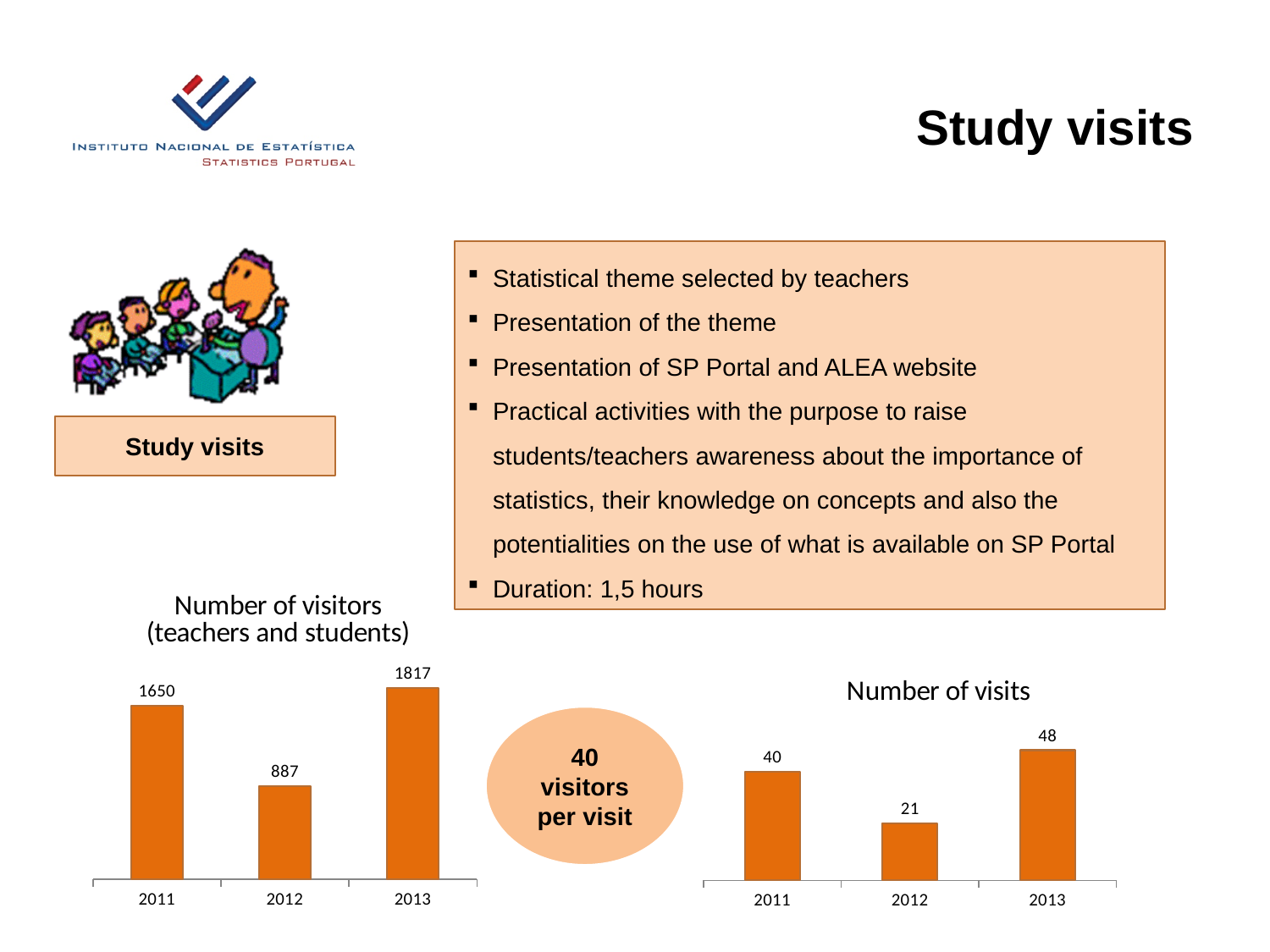
In the 'Number of visits' chart, is the value for 2011 larger or smaller than the value for 2013? smaller In the 'Number of visits' chart, which year has the lowest value? 2012 In the 'Number of visits' chart, what is the value for 2013? 48 In the 'Number of visits' chart, what is the value for 2012? 21 What kind of chart is the 'Number of visitors (teachers and students)' chart? bar chart In the 'Number of visits' chart, what is the difference between the values for 2013 and 2011? 8 How many years are shown on the x axis of the 'Number of visits' chart? 3 In the 'Number of visitors (teachers and students)' chart, which year has the highest value? 2013 In the 'Number of visitors (teachers and students)' chart, what is the value for 2012? 887 In the 'Number of visitors (teachers and students)' chart, which year has the lowest value? 2012 In the 'Number of visitors (teachers and students)' chart, what is the value for 2011? 1650 In the 'Number of visitors (teachers and students)' chart, what is the difference between the values for 2013 and 2011? 167